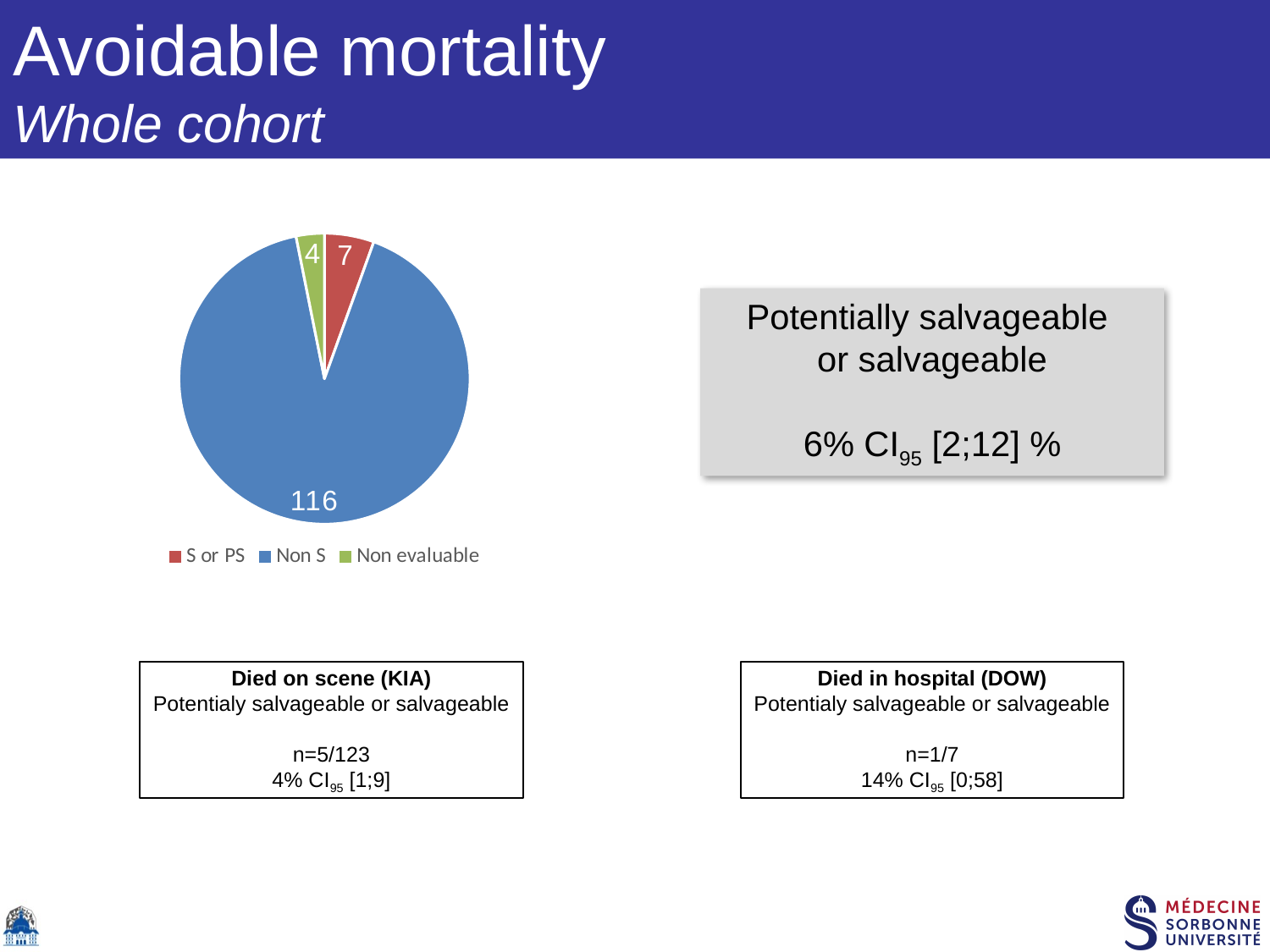
What is the value for the S or PS slice of the pie chart? 7 What is the difference between the Non S value and the S or PS value in the pie chart? 109 How many slices does the pie chart have? 3 Which category has the smallest slice in the pie chart? Non evaluable What is the value for the Non evaluable slice of the pie chart? 4 What is the difference between the S or PS value and the Non evaluable value in the pie chart? 3 What is the value for the Non S slice of the pie chart? 116 What kind of chart is shown on the slide? pie chart How many entries does the legend of the pie chart list? 3 What colour is the Non S slice in the pie chart? blue Which is larger in the pie chart, S or PS or Non evaluable? S or PS Which category has the largest slice in the pie chart? Non S